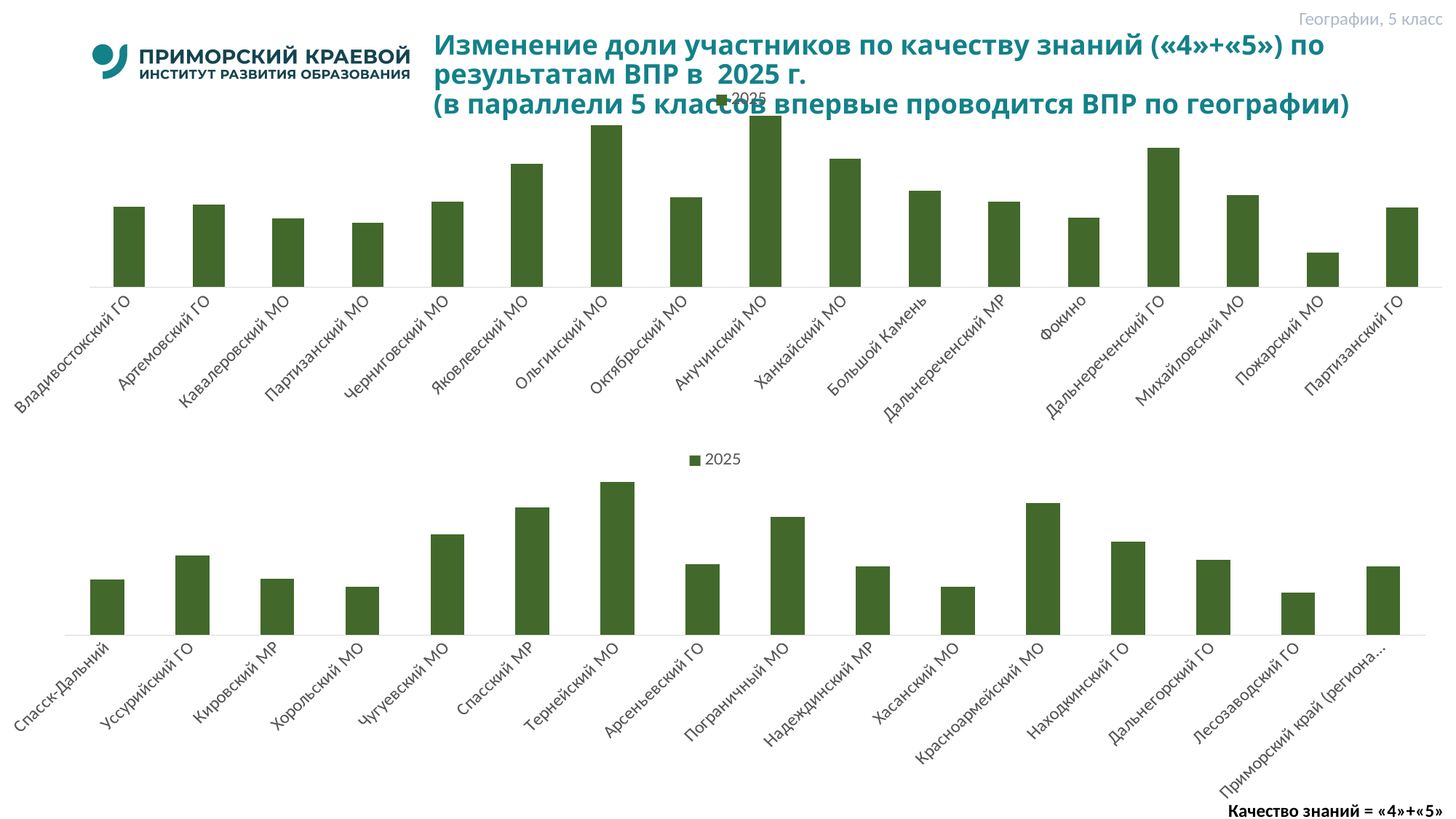
How many categories are shown in the bottom chart? 16 What kind of chart is the top chart on the slide? Bar chart In the bottom chart, which is larger: the value for Чугуевский МО or for Уссурийский ГО? Чугуевский МО In the bottom chart, which is larger: the value for Красноармейский МО or for Пограничный МО? Красноармейский МО How many series does the legend of the bottom chart list? 1 How many categories are shown in the top chart? 17 In the top chart, which is larger: the value for Дальнереченский ГО or for Михайловский МО? Дальнереченский ГО In the top chart, which category has the highest bar? Анучинский МО In the top chart, which category has the lowest bar? Пожарский МО What is the legend entry shown for the bottom chart? 2025 In the bottom chart, which category has the highest bar? Тернейский МО